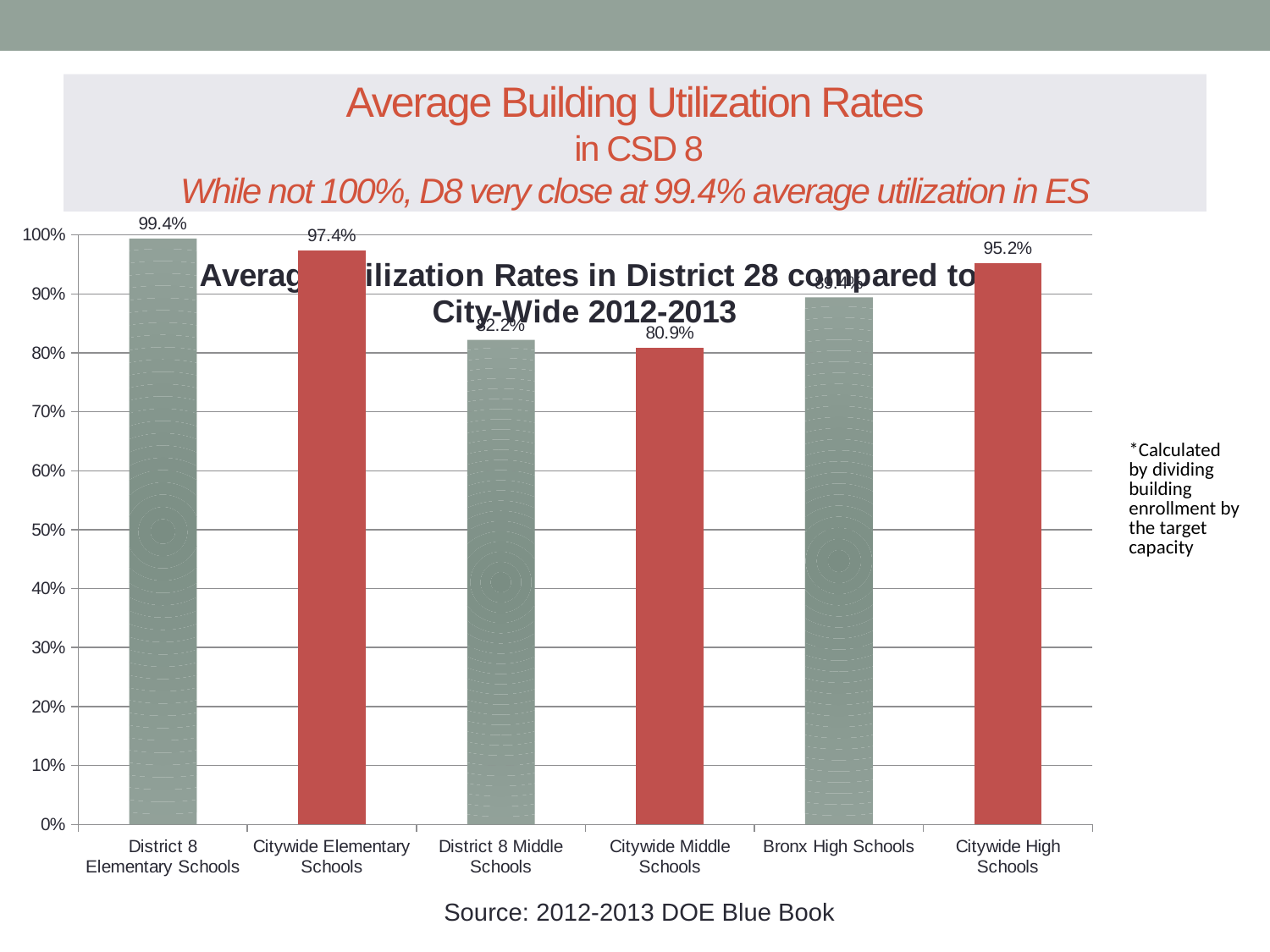
Which category has the lowest utilization rate? Citywide Middle Schools Which category has the highest utilization rate? District 8 Elementary Schools What is the utilization rate shown for Citywide Middle Schools? 80.9% What is the utilization rate shown for Citywide Elementary Schools? 97.4% What is the utilization rate shown for Citywide High Schools? 95.2% Which is larger, the utilization rate for Citywide Elementary Schools or for Citywide High Schools? Citywide Elementary Schools What is the utilization rate shown for District 8 Middle Schools? 82.2% How many categories are shown on the x axis of the chart? 6 What is the average building utilization rate for District 8 Elementary Schools? 99.4% How much higher is the utilization rate for District 8 Elementary Schools than for Citywide Elementary Schools? 2.0% What kind of chart is shown on the slide? bar chart Is the value for Bronx High Schools greater or less than 80%? greater